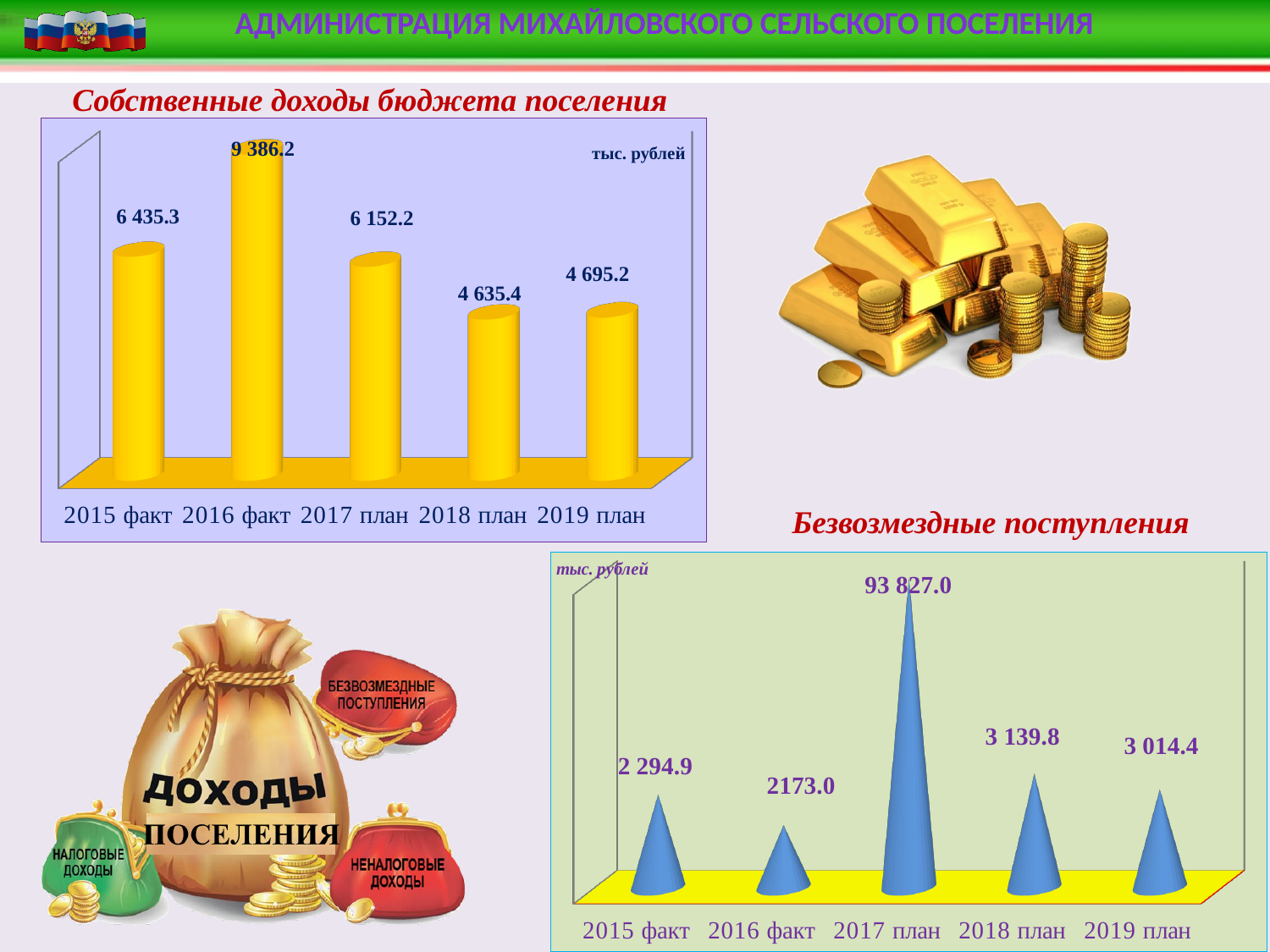
In the chart 'Собственные доходы бюджета поселения', which category has the highest value? 2016 факт In the chart 'Собственные доходы бюджета поселения', which category has the lowest value? 2018 план In the chart 'Собственные доходы бюджета поселения', what is the value for 2018 план? 4 635.4 In the chart 'Собственные доходы бюджета поселения', what is the difference between the values for 2016 факт and 2015 факт? 2 950.9 In the chart 'Безвозмездные поступления', what is the value for 2017 план? 93 827.0 In the chart 'Безвозмездные поступления', which is larger: the value for 2018 план or 2019 план? 2018 план In the chart 'Собственные доходы бюджета поселения', how many categories are shown on the x axis? 5 In the chart 'Безвозмездные поступления', what is the value for 2016 факт? 2173.0 In the chart 'Безвозмездные поступления', which category has the lowest value? 2016 факт In the chart 'Безвозмездные поступления', what is the difference between the values for 2018 план and 2019 план? 125.4 What kind of chart is 'Собственные доходы бюджета поселения'? bar chart In the chart 'Собственные доходы бюджета поселения', what is the value for 2016 факт? 9 386.2